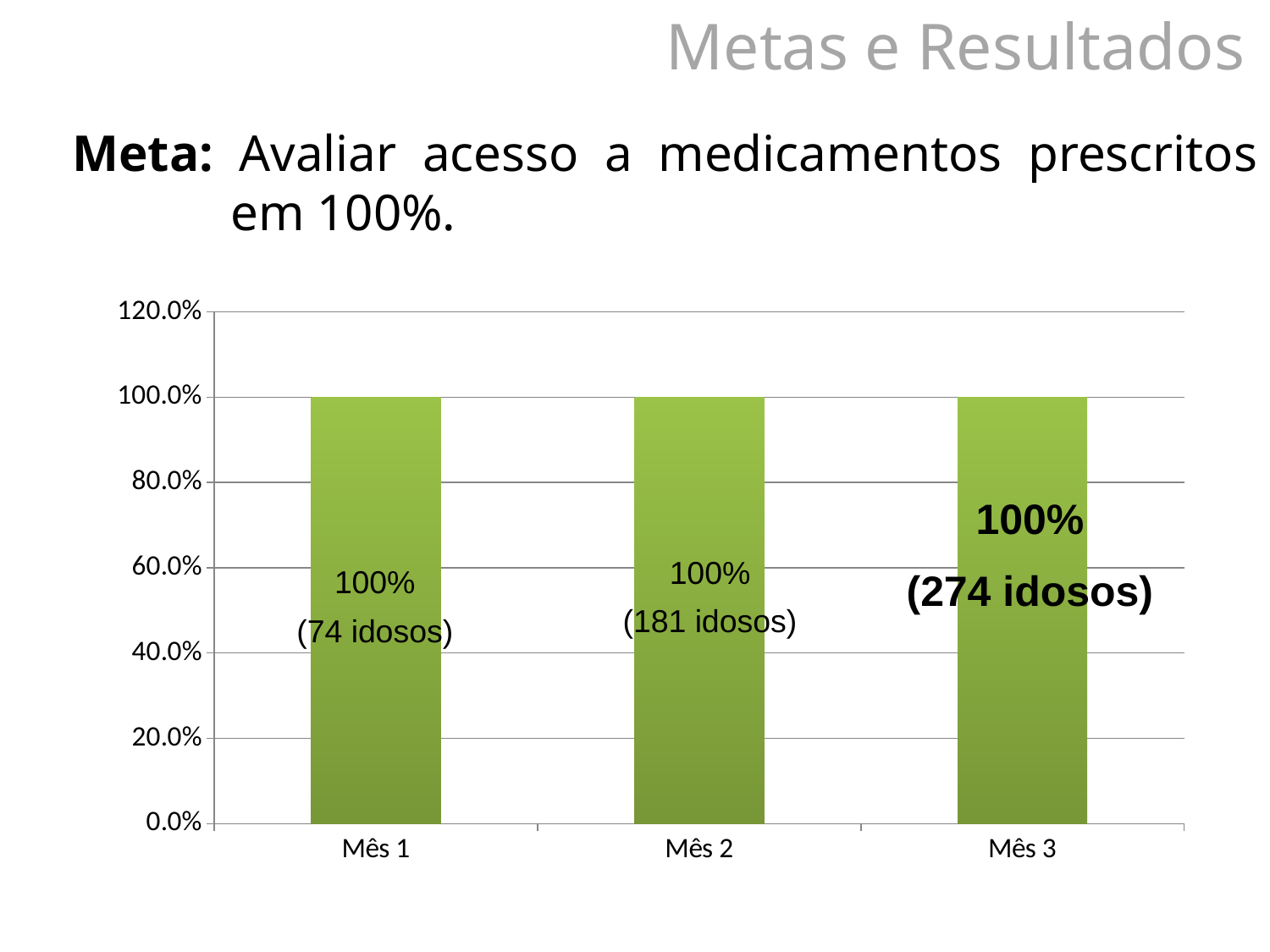
What is the difference between the percentage values for Mês 1 and Mês 2? 0% How many idosos are indicated in the data label for Mês 3? 274 idosos How many idosos are indicated in the data label for Mês 2? 181 idosos What kind of chart is shown on the slide? bar chart What is the value shown for Mês 1? 100% What is the value shown for Mês 3? 100% Is the value for Mês 2 greater or less than 80.0%? greater How many categories are shown on the x axis of the chart? 3 What is the highest value shown on the y axis of the chart? 120.0% How many idosos are indicated in the data label for Mês 1? 74 idosos What is the difference between the number of idosos in Mês 3 and Mês 2? 93 idosos Do the percentage values rise, fall or stay the same from Mês 1 to Mês 3? stay the same